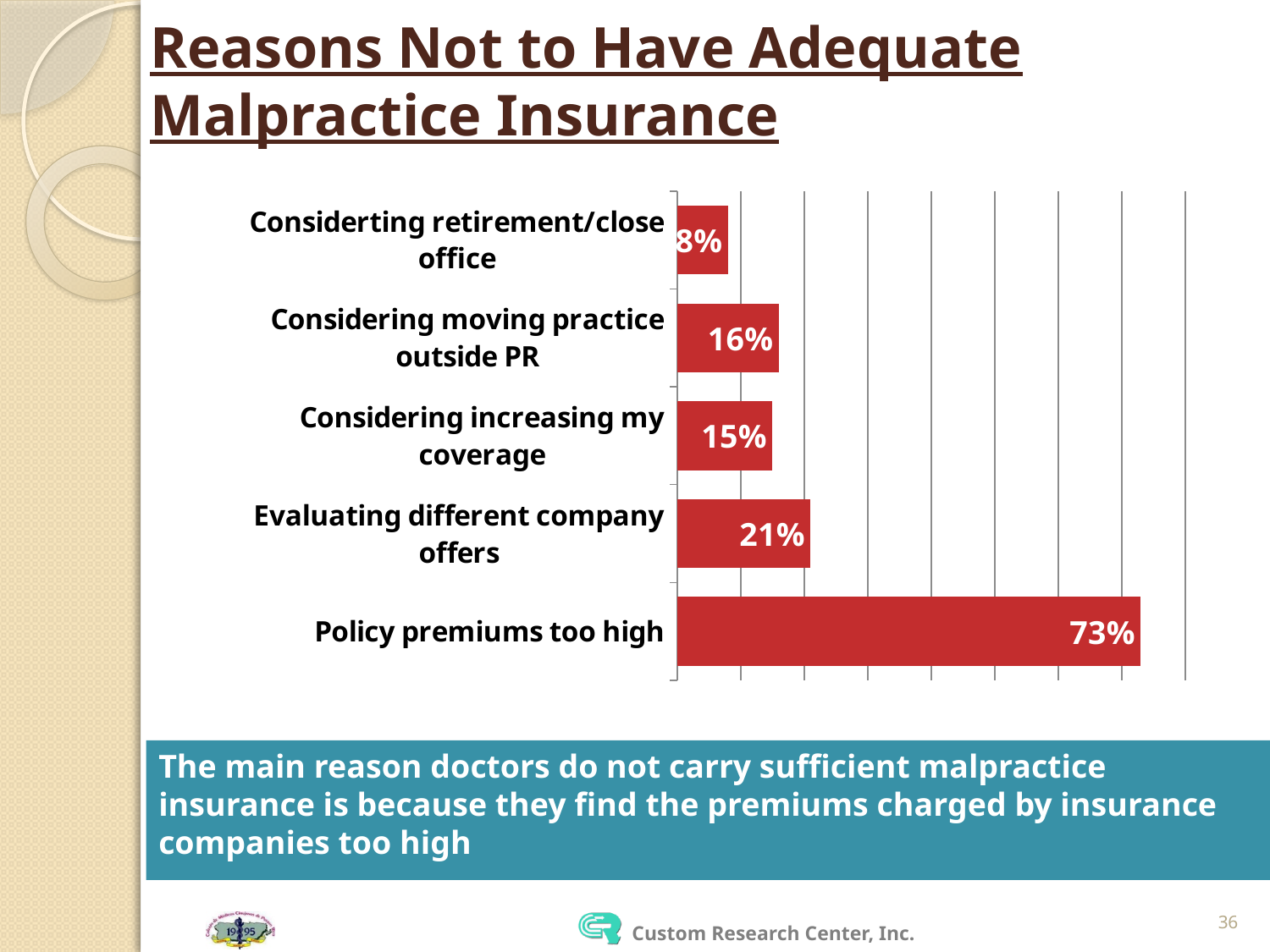
What percentage is shown for "Policy premiums too high"? 73% What percentage is shown for "Considerting retirement/close office"? 8% What percentage is shown for "Considering increasing my coverage"? 15% Which is larger: the value for "Considering moving practice outside PR" or the value for "Considering increasing my coverage"? Considering moving practice outside PR How many reasons (categories) are shown in the chart? 5 Which reason has the lowest percentage? Considerting retirement/close office Which reason has the highest percentage? Policy premiums too high What type of chart is shown on the slide? Bar chart What is the difference in percentage points between "Policy premiums too high" and "Evaluating different company offers"? 52 What percentage is shown for "Evaluating different company offers"? 21% What percentage is shown for "Considering moving practice outside PR"? 16% What is the title of the slide containing the chart? Reasons Not to Have Adequate Malpractice Insurance